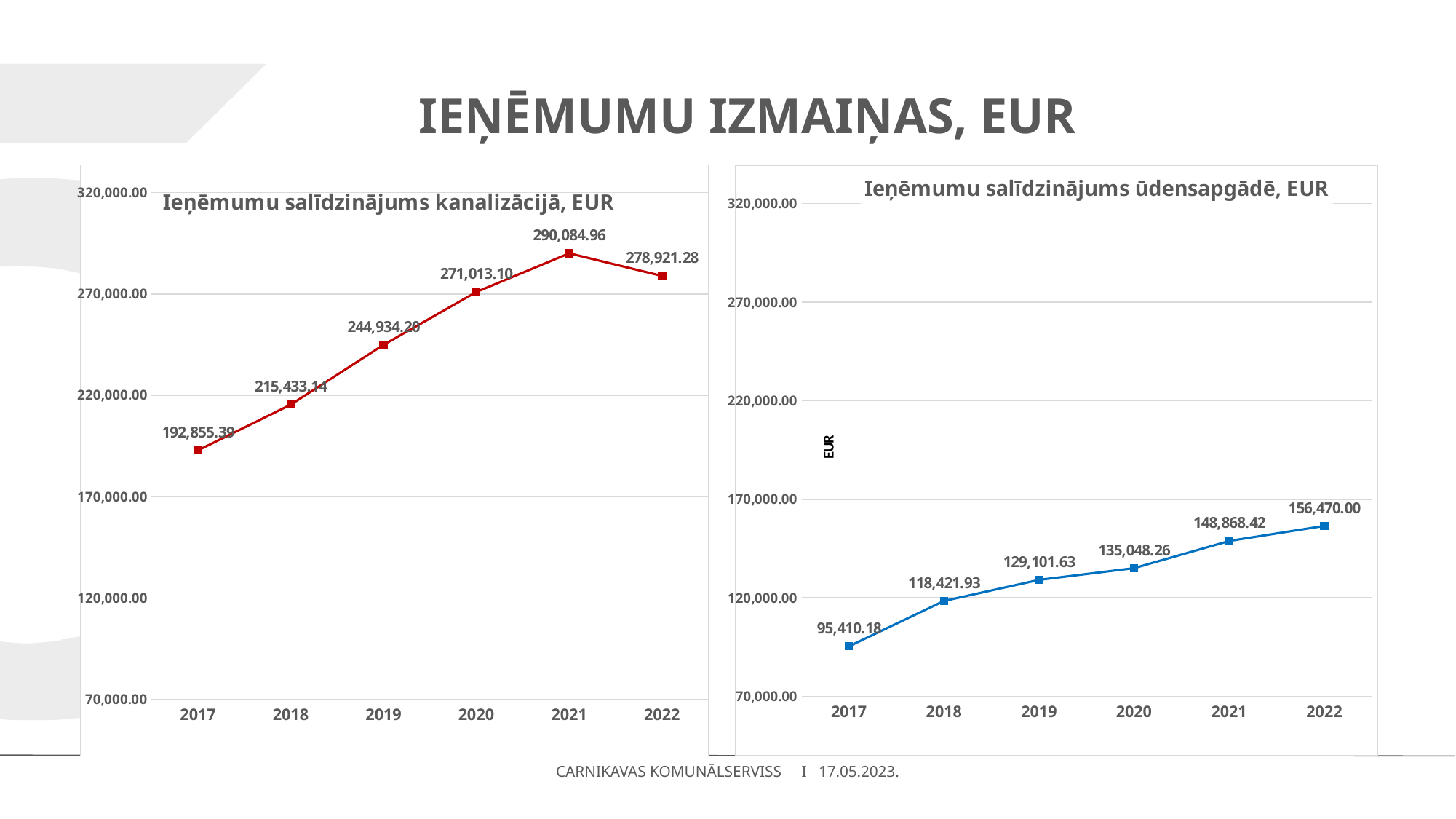
In the chart 'Ieņēmumu salīdzinājums kanalizācijā, EUR', which year has the highest value? 2021 In the chart 'Ieņēmumu salīdzinājums kanalizācijā, EUR', what is the value for 2021? 290,084.96 In the chart 'Ieņēmumu salīdzinājums kanalizācijā, EUR', what is the difference between the 2021 and 2022 values? 11,163.68 In the chart 'Ieņēmumu salīdzinājums ūdensapgādē, EUR', what is the value for 2022? 156,470.00 In the chart 'Ieņēmumu salīdzinājums kanalizācijā, EUR', what is the value for 2017? 192,855.39 In the chart 'Ieņēmumu salīdzinājums ūdensapgādē, EUR', what is the value for 2019? 129,101.63 In the chart 'Ieņēmumu salīdzinājums kanalizācijā, EUR', is the value for 2020 greater or less than 270,000.00? greater In the chart 'Ieņēmumu salīdzinājums ūdensapgādē, EUR', is the value for 2018 greater or less than 120,000.00? less What kind of chart is 'Ieņēmumu salīdzinājums kanalizācijā, EUR'? line chart In the chart 'Ieņēmumu salīdzinājums ūdensapgādē, EUR', how much higher is the 2022 value than the 2017 value? 61,059.82 In the chart 'Ieņēmumu salīdzinājums ūdensapgādē, EUR', which year has the lowest value? 2017 How many years are plotted in the chart 'Ieņēmumu salīdzinājums ūdensapgādē, EUR'? 6